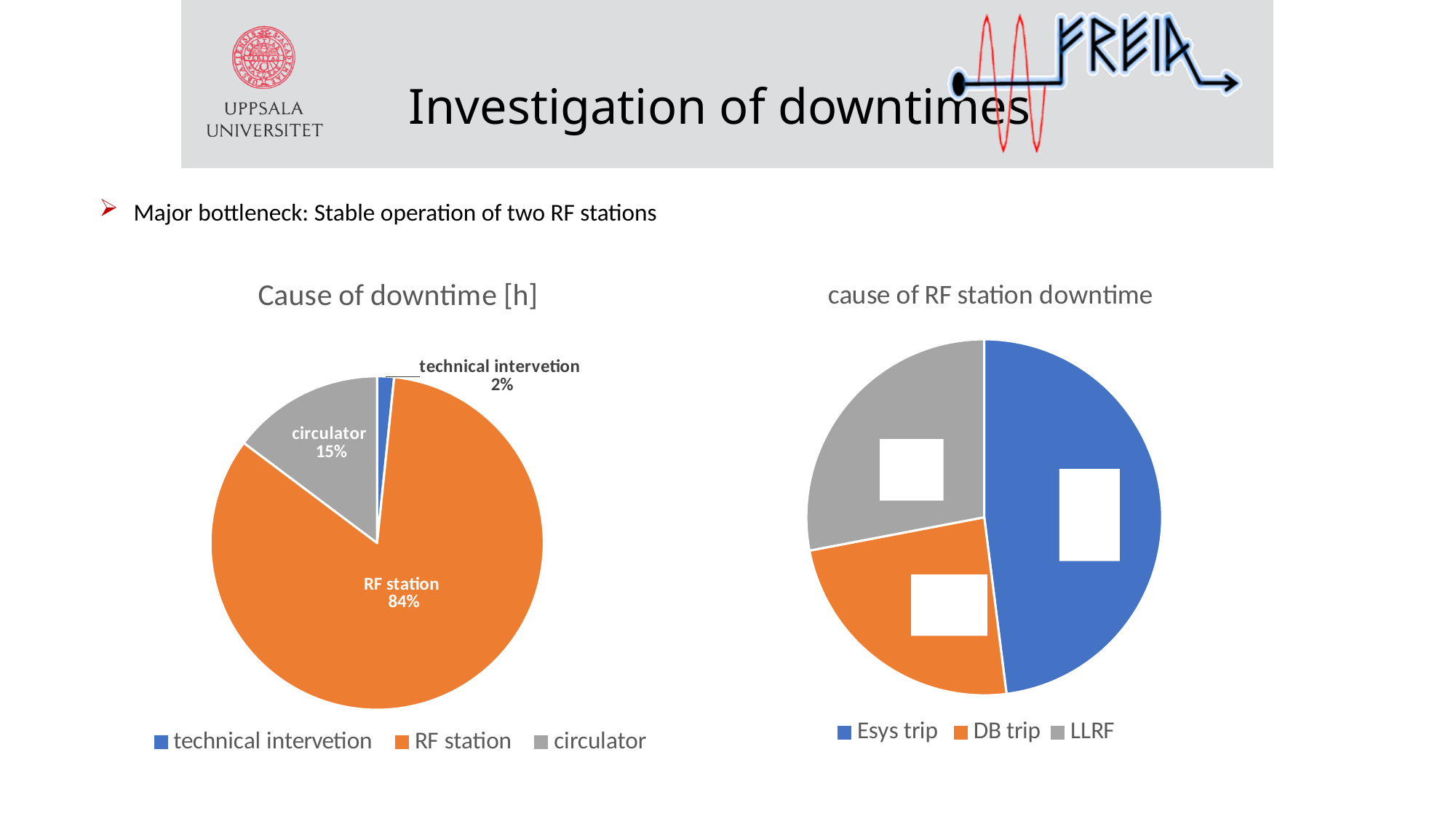
In the 'Cause of downtime [h]' chart, which is larger: the circulator slice or the technical intervetion slice? circulator In the 'Cause of downtime [h]' chart, what share of downtime is attributed to circulator? 15% How many categories are shown in the 'Cause of downtime [h]' chart? 3 In the 'cause of RF station downtime' chart on the right, which category has the largest slice? Esys trip How many entries does the legend of the 'cause of RF station downtime' chart list? 3 What kind of chart is the 'Cause of downtime [h]' chart on the left? pie chart What is the title of the chart on the right side of the slide? cause of RF station downtime In the 'Cause of downtime [h]' chart, which category has the smallest slice? technical intervetion In the 'Cause of downtime [h]' chart, by how many percentage points does the RF station share exceed the circulator share? 69 percentage points In the 'Cause of downtime [h]' chart, what share of downtime is attributed to technical intervetion? 2% In the 'Cause of downtime [h]' chart, which category has the largest slice? RF station In the 'Cause of downtime [h]' chart, what share of downtime is attributed to RF station? 84%